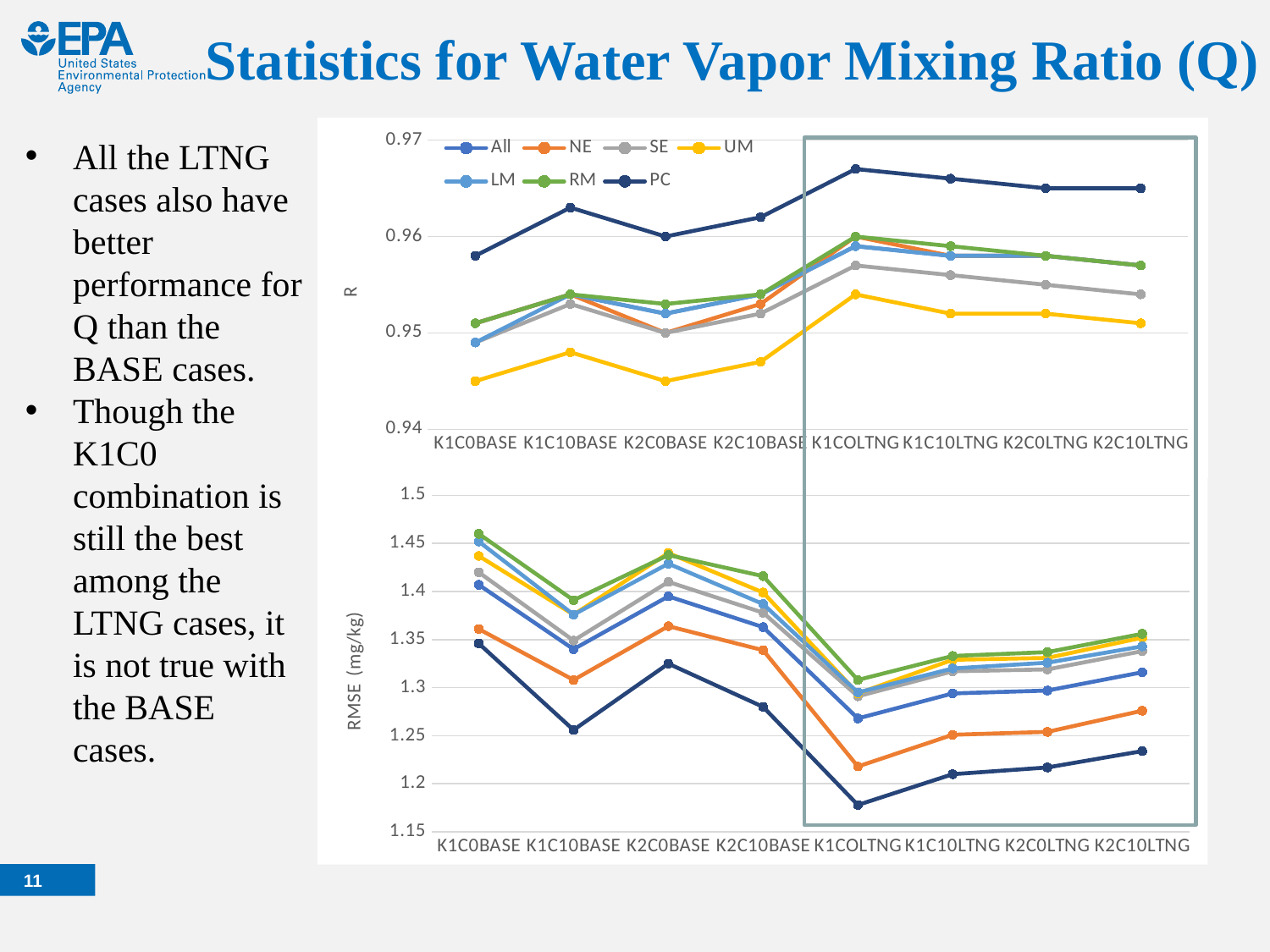
In the bottom chart (RMSE), is the value for PC at K1C0LTNG greater or less than 1.2? less How many categories are shown on the x axis of the bottom chart? 8 In the bottom chart (RMSE), is the value for RM at K1C0BASE greater or less than 1.4? greater In the top chart (R), is the value for PC at K1C0LTNG greater or less than 0.96? greater In the bottom chart (RMSE), does the PC series rise or fall from K2C10BASE to K1C0LTNG? fall What type of chart is the top chart on the slide? line chart In the bottom chart (RMSE), which series has the lowest value at K1C0LTNG? PC In the top chart (R), which series has the highest value at K1C0LTNG? PC What is the y-axis label of the bottom chart? RMSE (mg/kg) In the top chart (R), which series has the lowest value at K1C0BASE? UM How many series does the legend of the top chart list? 7